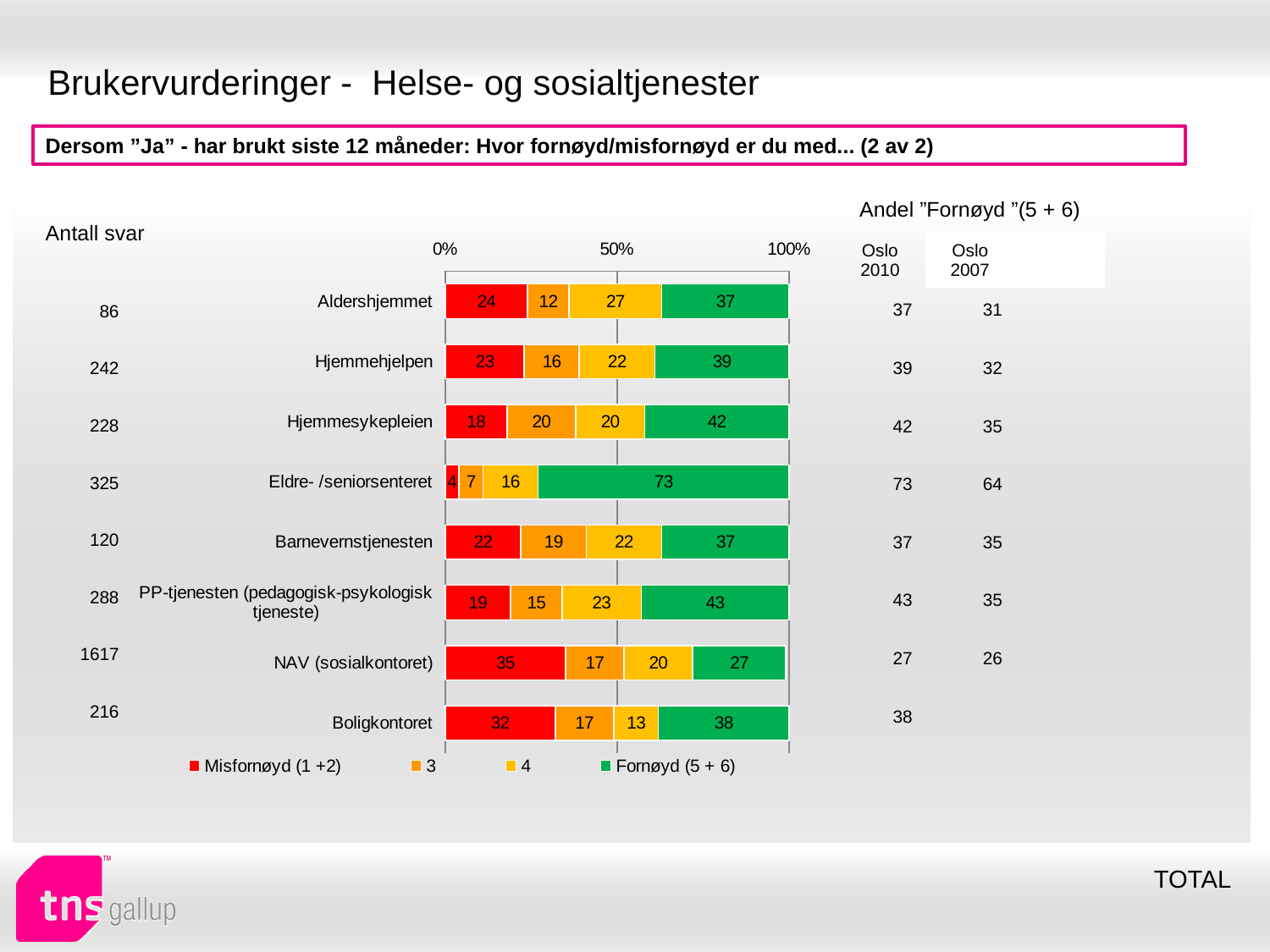
How many categories (bars) are shown in the chart? 8 Which has the larger Misfornøyd (1 +2) value, NAV (sosialkontoret) or Boligkontoret? NAV (sosialkontoret) What is the total of the stacked bar for Aldershjemmet? 100 Which category has the lowest Fornøyd (5 + 6) value? NAV (sosialkontoret) Which category has the highest Fornøyd (5 + 6) value? Eldre- /seniorsenteret What is the value of the Misfornøyd (1 +2) segment for NAV (sosialkontoret)? 35 How many series does the legend list? 4 What is the difference between the Fornøyd (5 + 6) values for Eldre- /seniorsenteret and Aldershjemmet? 36 What is the first entry in the chart legend? Misfornøyd (1 +2) What is the value of the Fornøyd (5 + 6) segment for Hjemmesykepleien? 42 What is the value of the '4' segment for Boligkontoret? 13 What kind of chart is shown on the slide? Stacked bar chart